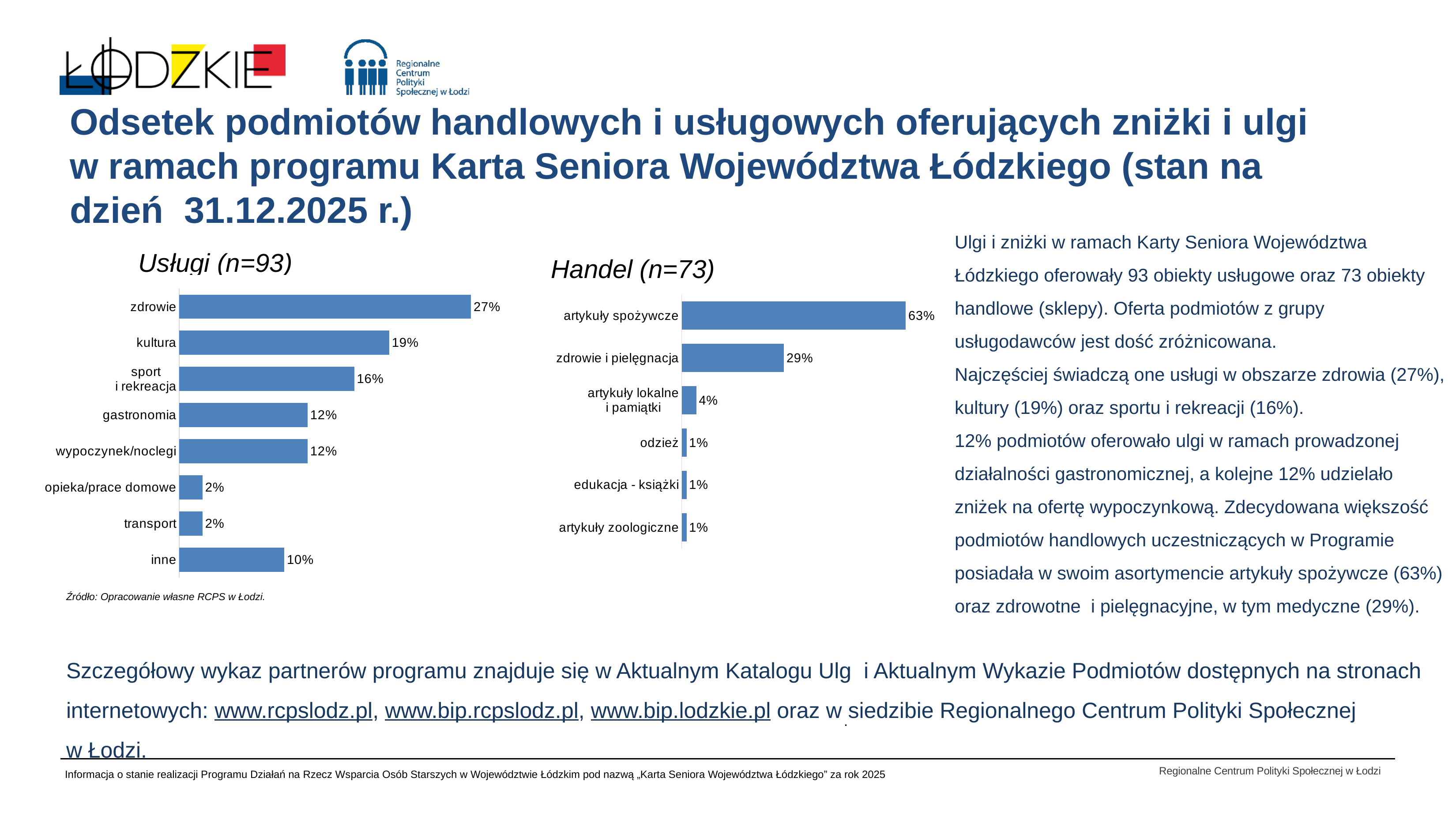
In the 'Handel (n=73)' chart, what is the difference between artykuły spożywcze and zdrowie i pielęgnacja? 34% In the 'Handel (n=73)' chart, what is the value for artykuły lokalne i pamiątki? 4% In the 'Usługi (n=93)' chart, which is larger: inne or transport? inne In the 'Usługi (n=93)' chart, what is the value for kultura? 19% In the 'Handel (n=73)' chart, how many categories are shown? 6 In the 'Usługi (n=93)' chart, how many categories are shown? 8 In the 'Handel (n=73)' chart, what is the value for artykuły spożywcze? 63% In the 'Usługi (n=93)' chart, what is the difference between zdrowie and sport i rekreacja? 11% What is the title of the chart on the left side of the slide? Usługi (n=93) What kind of chart is the 'Handel (n=73)' chart? bar chart In the 'Usługi (n=93)' chart, what is the value for zdrowie? 27% In the 'Usługi (n=93)' chart, which category has the highest value? zdrowie